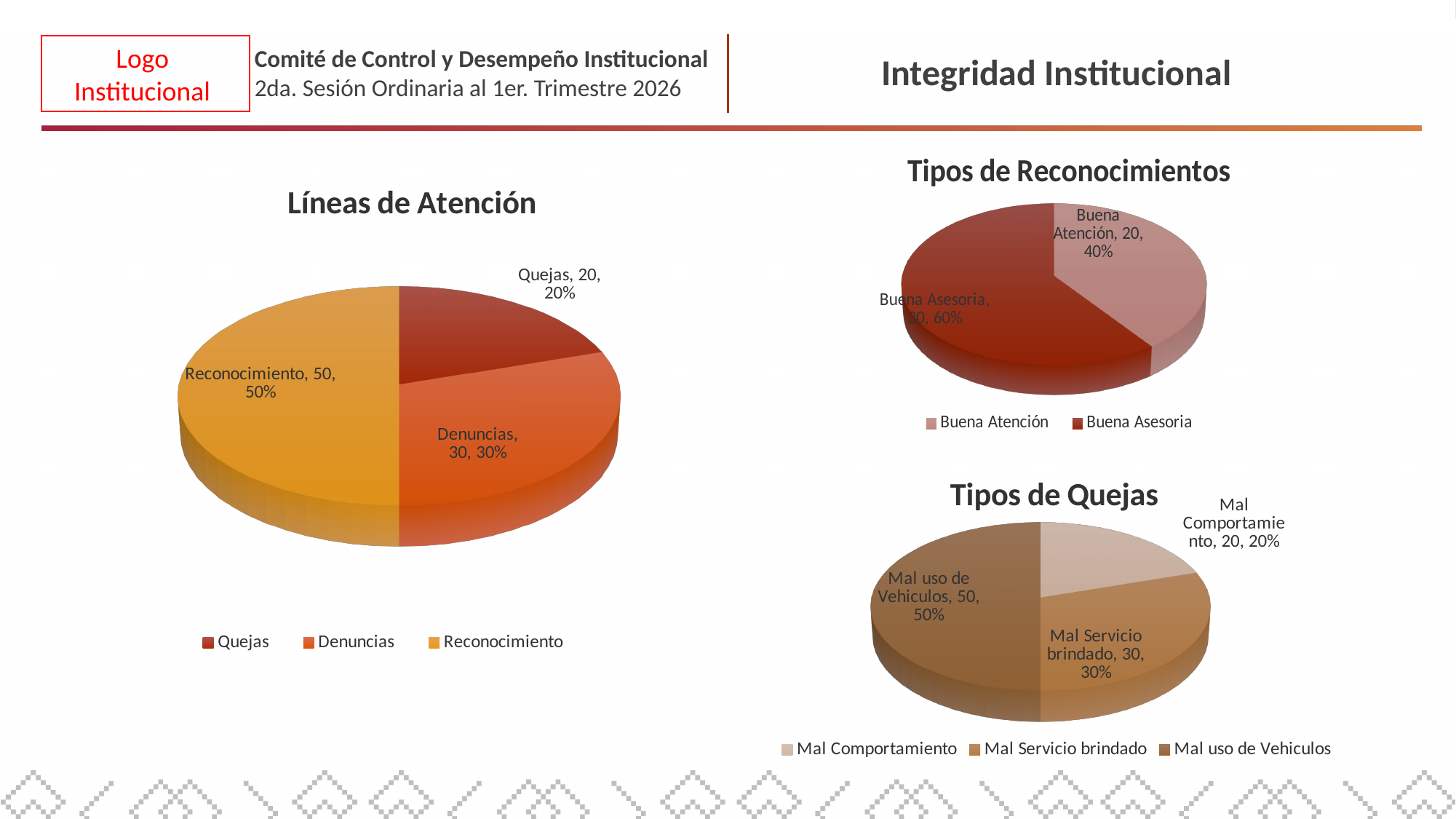
In the 'Líneas de Atención' chart, what is the difference between the values for Reconocimiento and Quejas? 30 In the 'Tipos de Reconocimientos' chart, which category has the smaller slice? Buena Atención What type of chart is 'Tipos de Reconocimientos'? Pie chart In the 'Líneas de Atención' chart, which category has the largest slice? Reconocimiento How many categories does the 'Tipos de Reconocimientos' chart show? 2 How many categories does the 'Tipos de Quejas' chart show? 3 In the 'Líneas de Atención' chart, what value is shown for Denuncias? 30 In the 'Líneas de Atención' chart, what share of the pie does Quejas represent? 20% In the 'Tipos de Quejas' chart, what value is shown for Mal uso de Vehiculos? 50 In the 'Tipos de Quejas' chart, which is larger: Mal Servicio brindado or Mal Comportamiento? Mal Servicio brindado In the 'Líneas de Atención' chart, what is the total of all three values? 100 In the 'Tipos de Reconocimientos' chart, what percentage is shown for Buena Asesoria? 60%